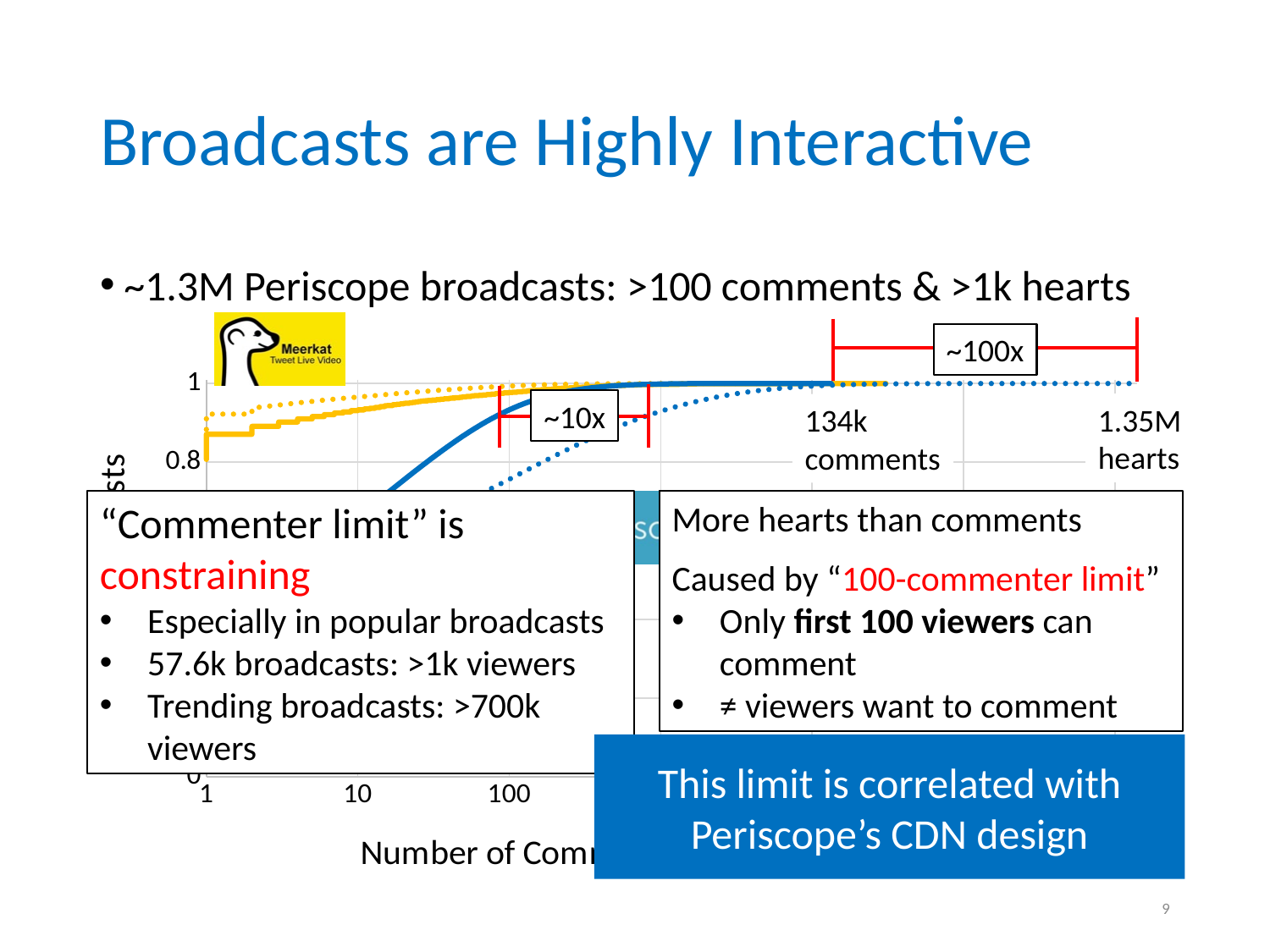
What two colours are used for the lines in the chart? yellow and blue Do the plotted lines rise or fall as the number of comments increases along the x axis? rise What is the highest tick value shown on the y axis of the chart? 1 What are the three x-axis tick values visible on the chart, from left to right? 1, 10, 100 What ratio is annotated between the 134k comments and 1.35M hearts endpoints? ~100x According to the annotation on the chart, what is the largest number of hearts reached? 1.35M hearts What ratio label is shown in the box near the middle of the chart, to the left of the ~100x annotation? ~10x According to the annotation on the chart, what is the largest number of comments reached? 134k comments What kind of chart is shown on the slide? line chart What is the first tick value shown on the x axis of the chart? 1